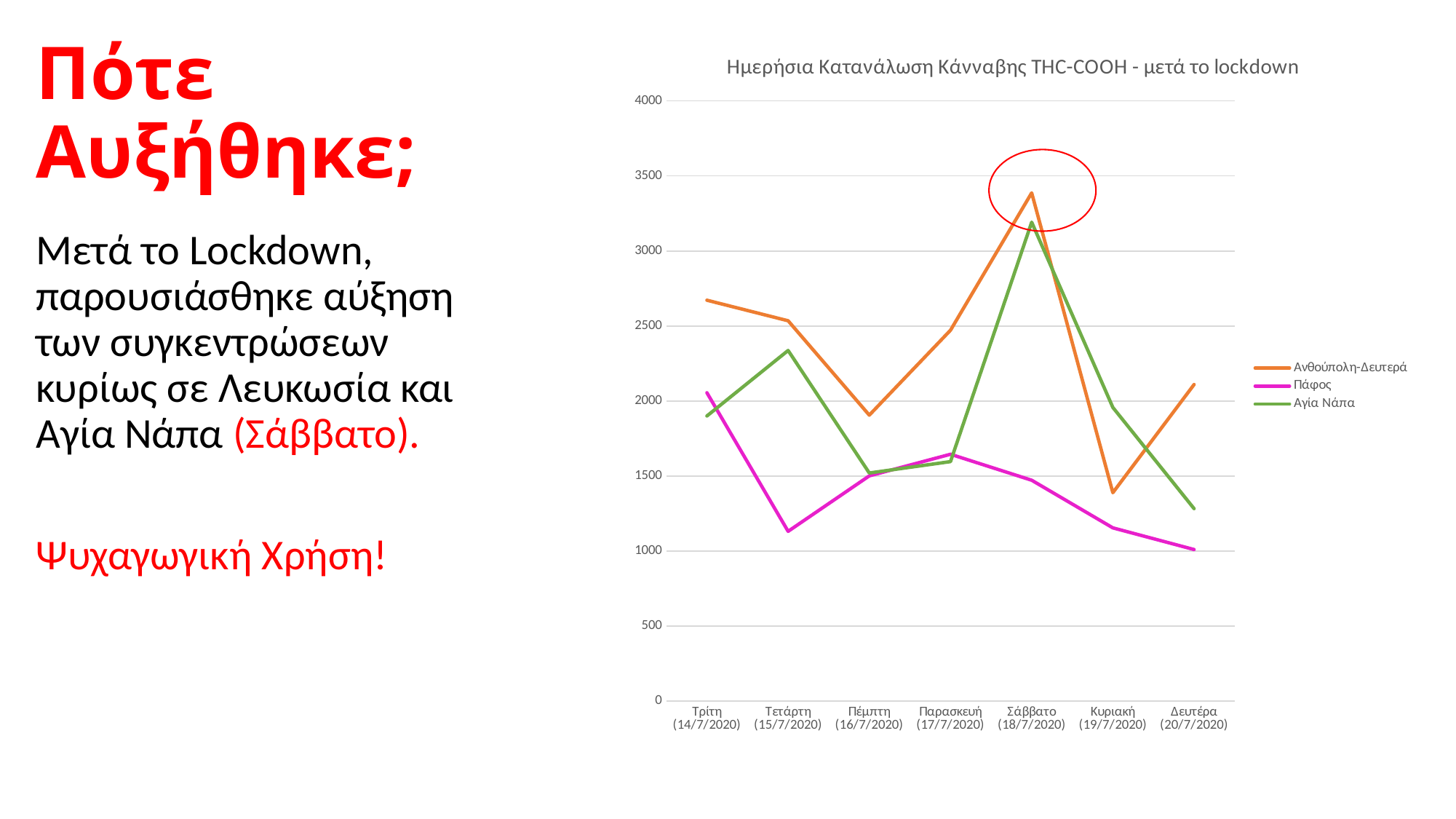
How many days are shown on the x axis? 7 On which day does the Αγία Νάπα line reach its highest value? Σάββατο (18/7/2020) What is the title of the chart? Ημερήσια Κατανάλωση Κάνναβης THC-COOH - μετά το lockdown How many series does the legend list? 3 Is the value for Ανθούπολη-Δευτερά on Σάββατο (18/7/2020) greater or less than 3000? greater On which day is the Πάφος line at its lowest? Δευτέρα (20/7/2020) Does the Πάφος line rise or fall from Παρασκευή (17/7/2020) to Δευτέρα (20/7/2020)? fall On Τρίτη (14/7/2020), which series has the higher value, Ανθούπολη-Δευτερά or Πάφος? Ανθούπολη-Δευτερά On which day does the Ανθούπολη-Δευτερά line reach its highest value? Σάββατο (18/7/2020) What kind of chart is shown on the slide? line chart Is the value for Πάφος on Τετάρτη (15/7/2020) greater or less than 1500? less Is the value for Ανθούπολη-Δευτερά on Τρίτη (14/7/2020) greater or less than 2500? greater